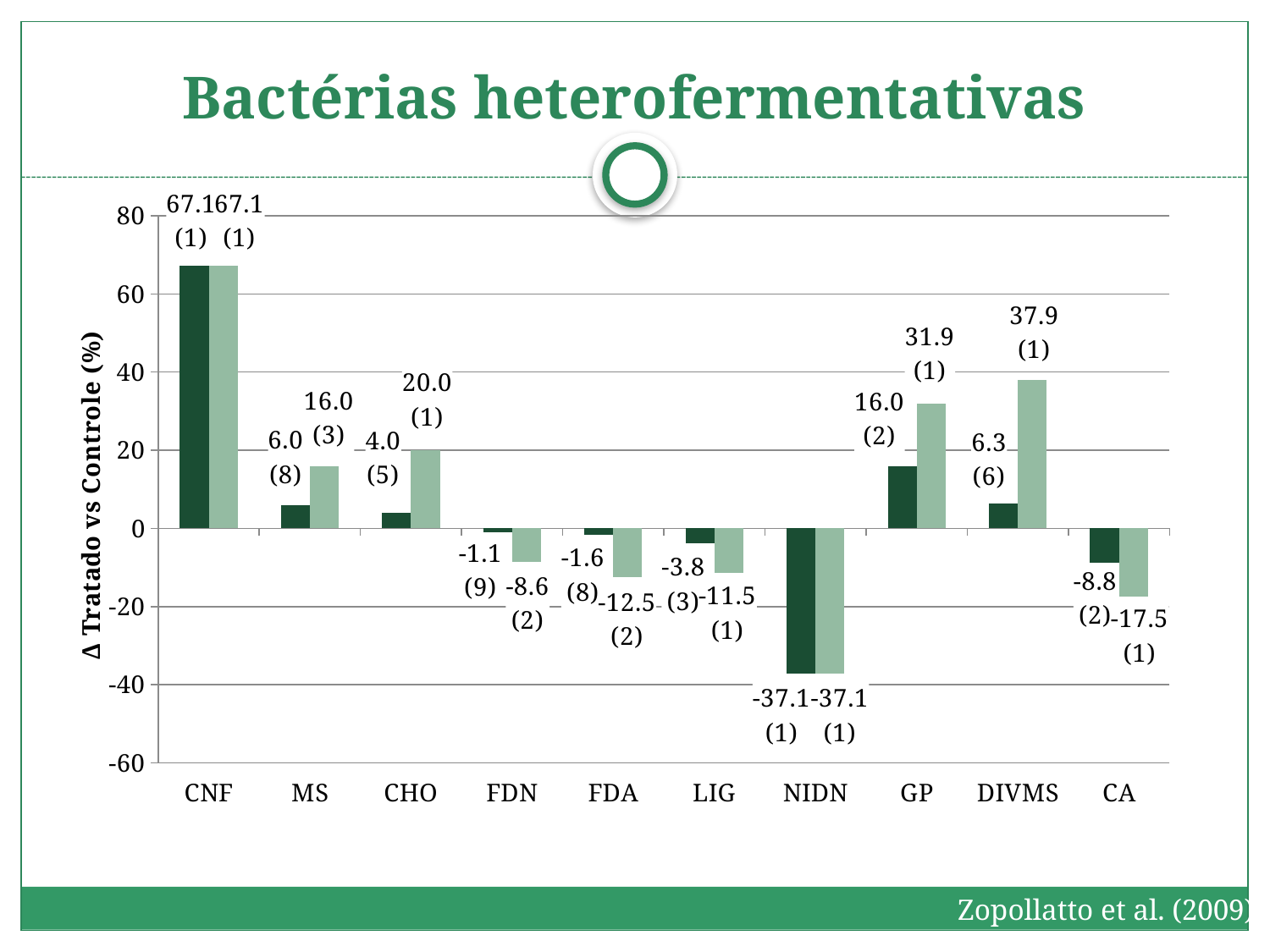
What is the difference between the light green and dark green bars for CHO? 16.0 What is the value of the light green bar for GP? 31.9 Which is larger, the light green bar for MS or the light green bar for CHO? CHO What is the value of the dark green bar for CNF? 67.1 Which category has the lowest value for the light green bars? NIDN Which category has the highest value for the dark green bars? CNF What is the value of the dark green bar for NIDN? -37.1 How many categories are shown on the x axis? 10 What is the value of the light green bar for DIVMS? 37.9 What is the label of the y axis? Δ Tratado vs Controle (%) What is the difference between the light green and dark green bars for GP? 15.9 What type of chart is shown on the slide? Bar chart